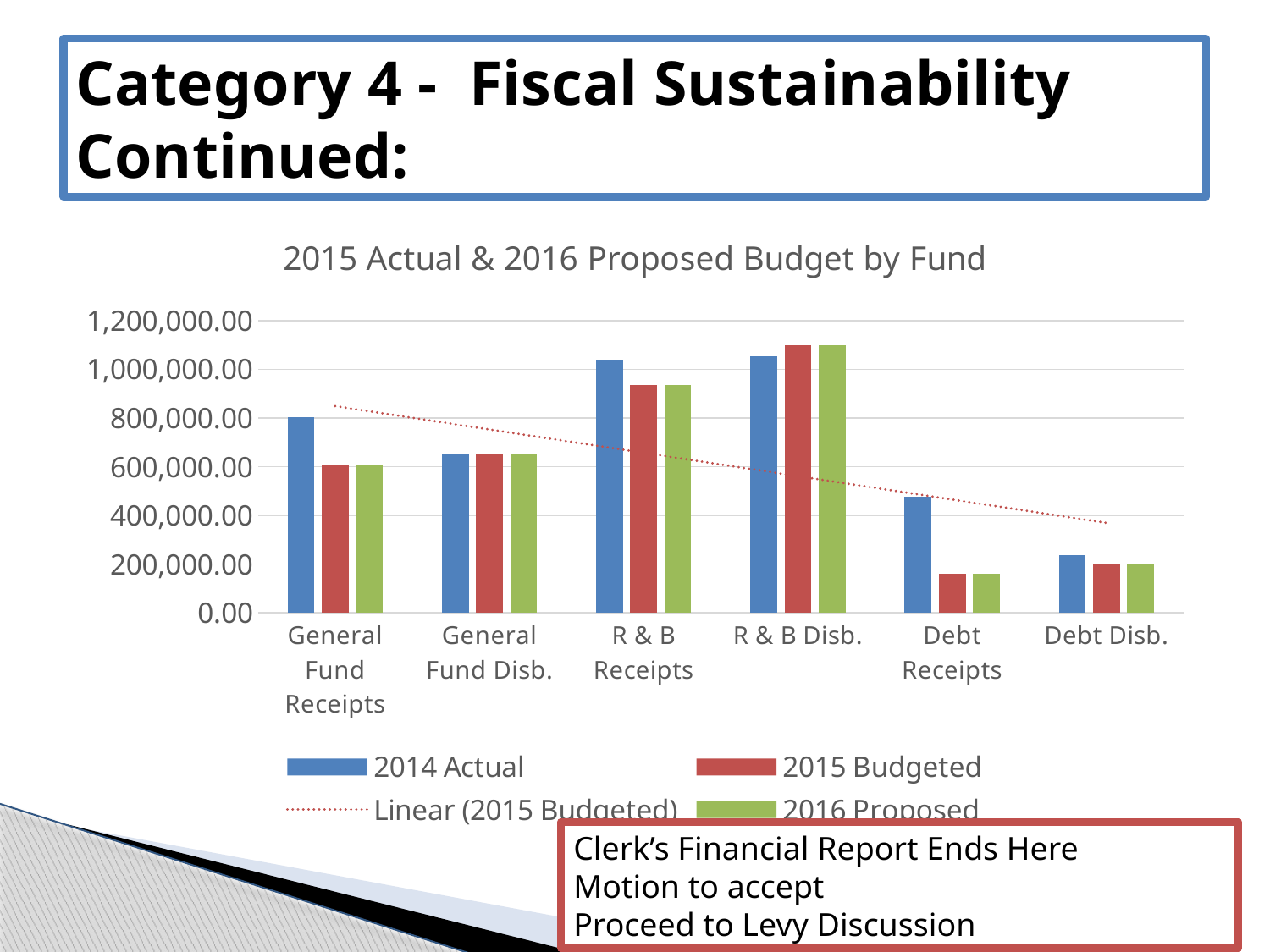
Is the 2016 Proposed value for Debt Receipts greater or less than 200,000.00? less What is the title of the chart? 2015 Actual & 2016 Proposed Budget by Fund Which category has the highest 2015 Budgeted value? R & B Disb. How many entries does the chart's legend list? 4 What type of chart is shown on the slide? Bar chart Which category has the lowest 2015 Budgeted value? Debt Receipts Is the 2014 Actual value for Debt Receipts greater or less than 600,000.00? less For General Fund Receipts, which is larger: the 2014 Actual value or the 2015 Budgeted value? 2014 Actual Does the Linear (2015 Budgeted) trendline rise or fall from left to right across the chart? Fall Which category has the lowest 2014 Actual value? Debt Disb. How many fund categories are shown on the x axis of the chart? 6 Is the 2015 Budgeted value for R & B Disb. greater or less than 1,000,000.00? greater